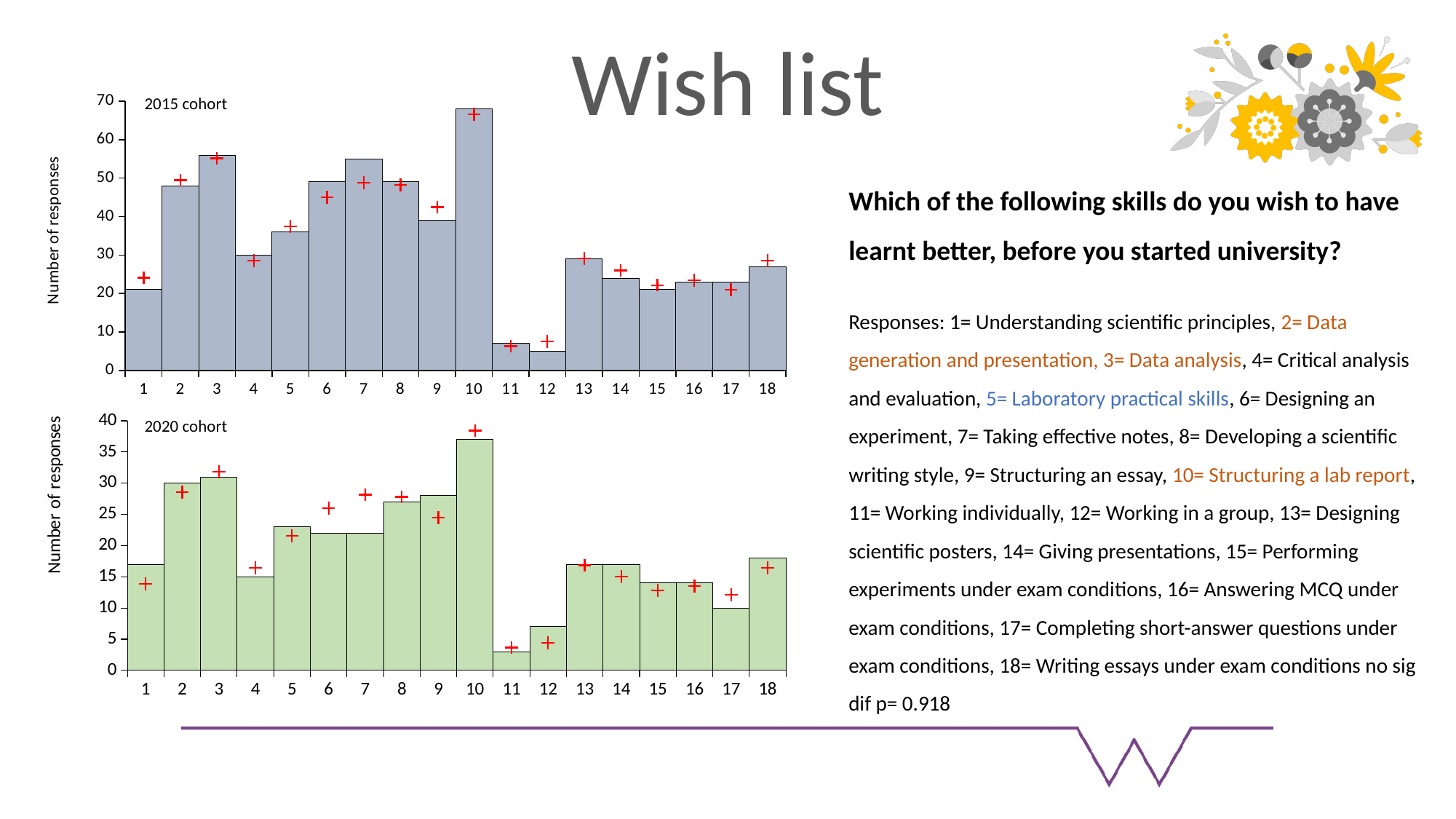
In the 2015 cohort chart, which category has the lowest number of responses? 12 What is the y-axis label on the 2020 cohort chart? Number of responses In the 2015 cohort chart, is the value for category 10 greater or less than 60? greater What kind of chart is the 2015 cohort chart? bar chart In the 2015 cohort chart, which is larger, the value for category 3 or the value for category 4? 3 In the 2020 cohort chart, which category has the highest number of responses? 10 In the 2020 cohort chart, is the value for category 12 greater or less than 10? less In the 2020 cohort chart, is the value for category 10 greater or less than 35? greater In the 2020 cohort chart, which category has the lowest number of responses? 11 How many categories are shown on the x axis of the 2020 cohort chart? 18 In the 2015 cohort chart, which category has the highest number of responses? 10